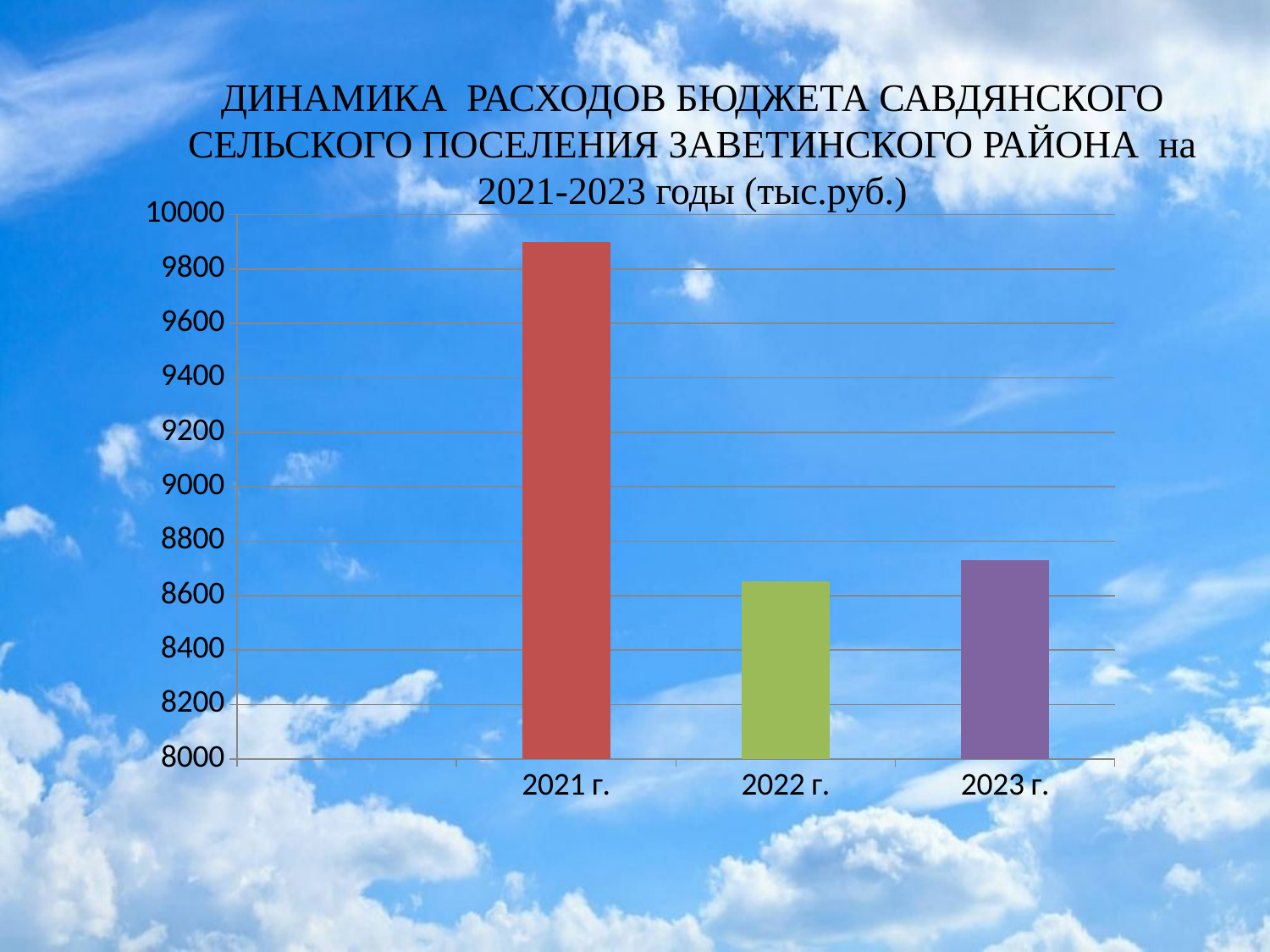
Is the value for 2021 г. greater or less than 9800? greater Which year has the highest budget expenditure? 2021 г. Is the value for 2023 г. greater or less than 9000? less What unit of measurement is given in the chart title? тыс.руб. What colour is the bar for 2021 г.? red Which year has the lowest budget expenditure? 2022 г. Is the value for 2023 г. greater or less than 8600? greater What kind of chart is shown on the slide? bar chart Do the expenditures rise or fall from 2021 г. to 2022 г.? fall Which is larger, the value for 2022 г. or the value for 2023 г.? 2023 г. How many years (categories) are plotted on the chart? 3